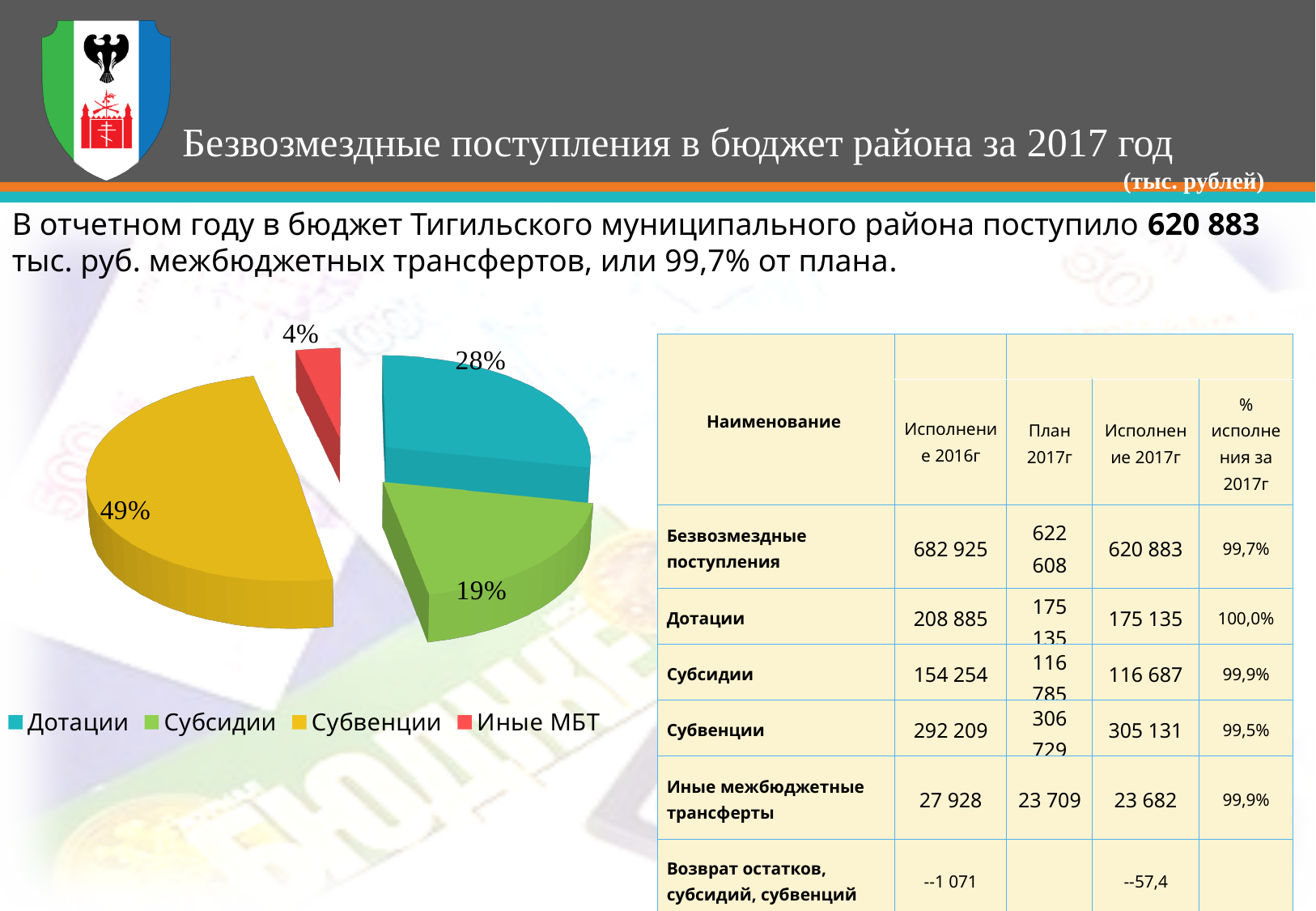
What share of the pie chart does Иные МБТ have? 4% How many entries does the pie chart legend list? 4 What is the difference in percentage points between the Субвенции slice and the Дотации slice? 21 How many slices does the pie chart have? 4 Which category has the smallest slice in the pie chart? Иные МБТ What share of the pie chart does Субсидии have? 19% What share of the pie chart does Субвенции have? 49% What colour is the Субвенции slice in the pie chart? yellow What kind of chart is shown on the slide? pie chart Which slice is larger in the pie chart, Дотации or Субсидии? Дотации Which category has the largest slice in the pie chart? Субвенции